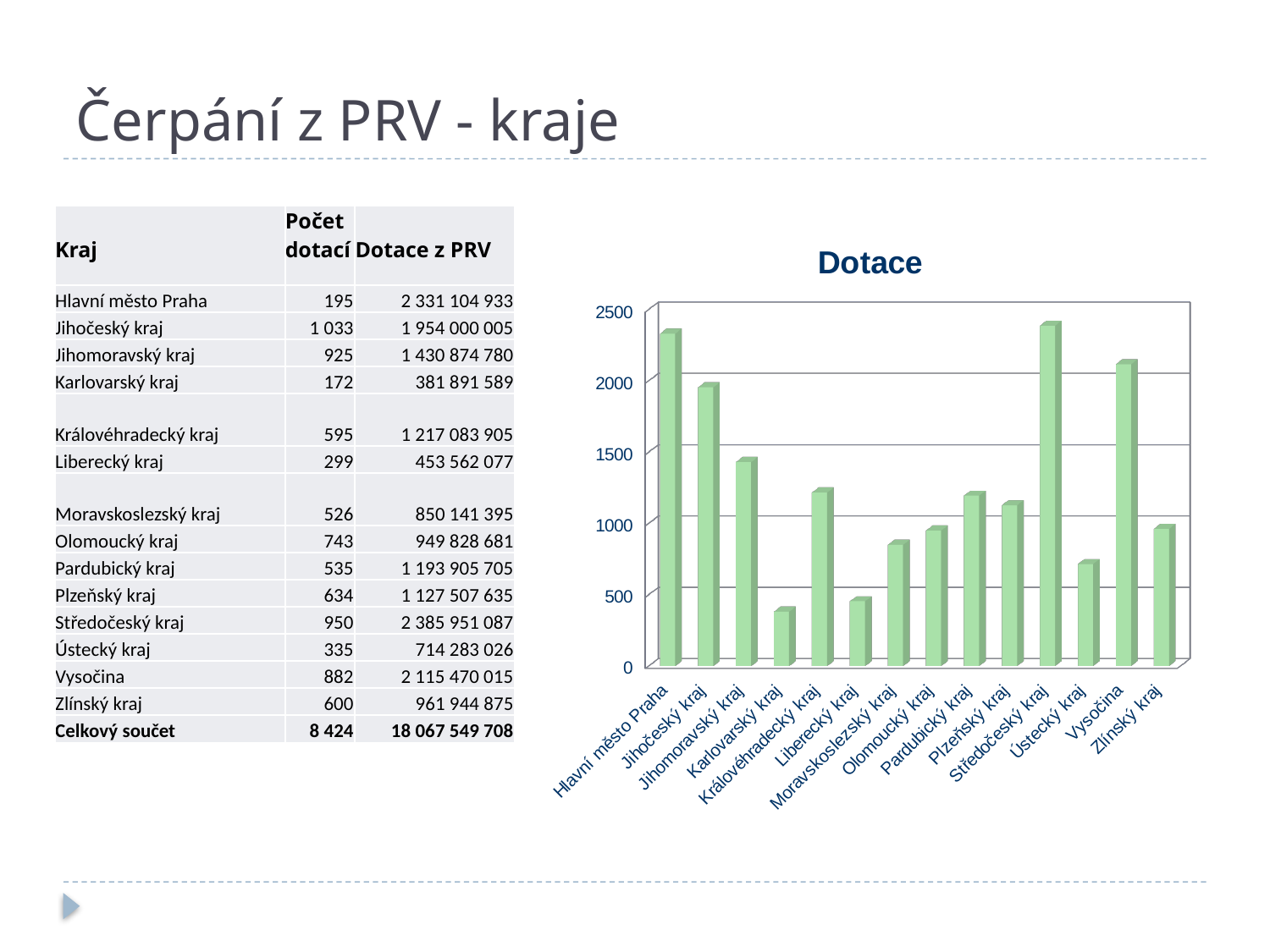
Is the value for Hlavní město Praha greater or less than 2000? greater Is the value for Ústecký kraj greater or less than 1000? less Which region has the tallest bar in the chart? Středočeský kraj What type of chart is shown on the slide? bar chart How many regions (kraje) are plotted in the chart? 14 Which region has the shortest bar in the chart? Karlovarský kraj Is the value for Karlovarský kraj greater or less than 500? less What is the title of the chart? Dotace Which has a larger value, Jihočeský kraj or Jihomoravský kraj? Jihočeský kraj Which has a larger value, Liberecký kraj or Ústecký kraj? Ústecký kraj